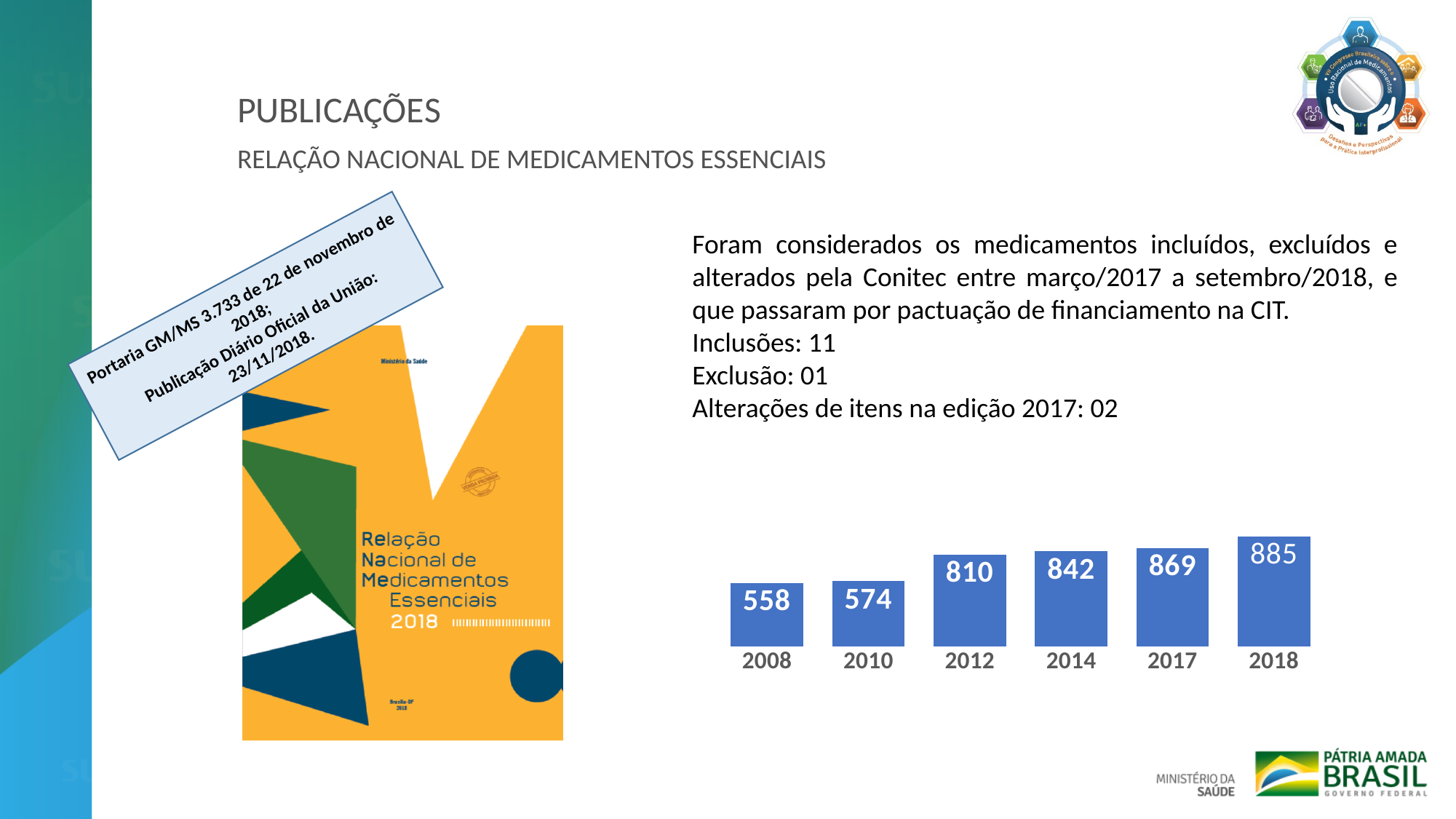
What is the value shown for 2017 in the bar chart? 869 How many years are shown in the bar chart? 6 Do the values in the bar chart rise or fall from 2008 to 2018? rise What is the value shown for 2008 in the bar chart? 558 Which year has the lowest value in the bar chart? 2008 What kind of chart is shown on the slide? bar chart What is the value shown for 2012 in the bar chart? 810 What is the difference between the values for 2018 and 2008? 327 Which year has the highest value in the bar chart? 2018 What colour are the bars in the chart? blue Which is larger, the value for 2014 or the value for 2010? 2014 What is the difference between the values for 2012 and 2010? 236